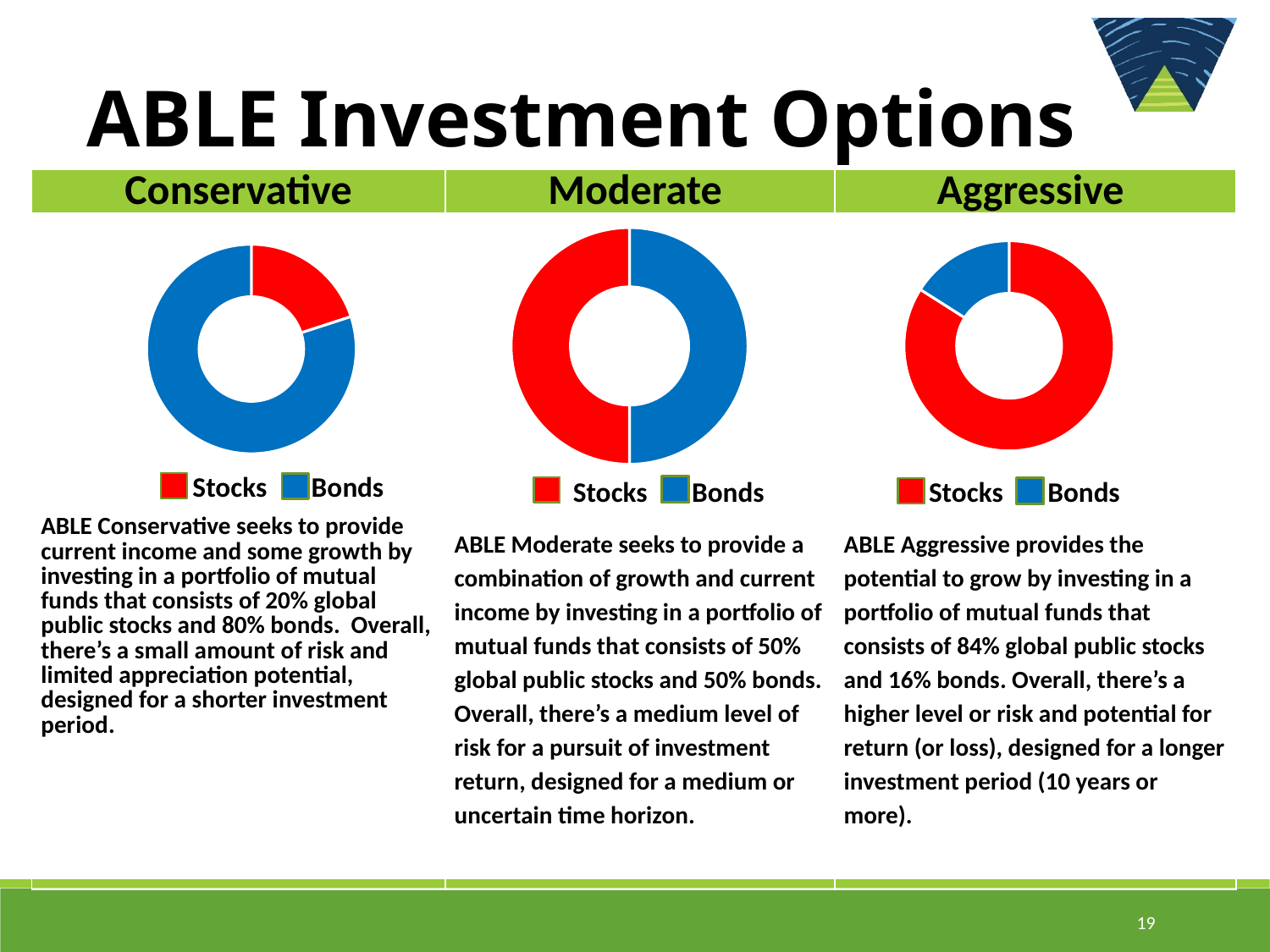
In the Aggressive chart, which slice is larger, Stocks or Bonds? Stocks According to the slide, what share of the Aggressive portfolio is global public stocks? 84% What kind of chart is shown under the Conservative heading? Donut (pie) chart What are the three headings above the charts, from left to right? Conservative, Moderate, Aggressive According to the slide, what share of the Moderate portfolio is bonds? 50% How many donut charts are on the slide? 3 In the Conservative chart, which slice is larger, Stocks or Bonds? Bonds In the Aggressive chart, which category has the smallest slice? Bonds In the Conservative chart, how many categories does the legend list? 2 According to the slide, what share of the Conservative portfolio is bonds? 80% In the Conservative chart, which category has the smallest slice? Stocks What colour represents Stocks in the legends of the three charts? Red